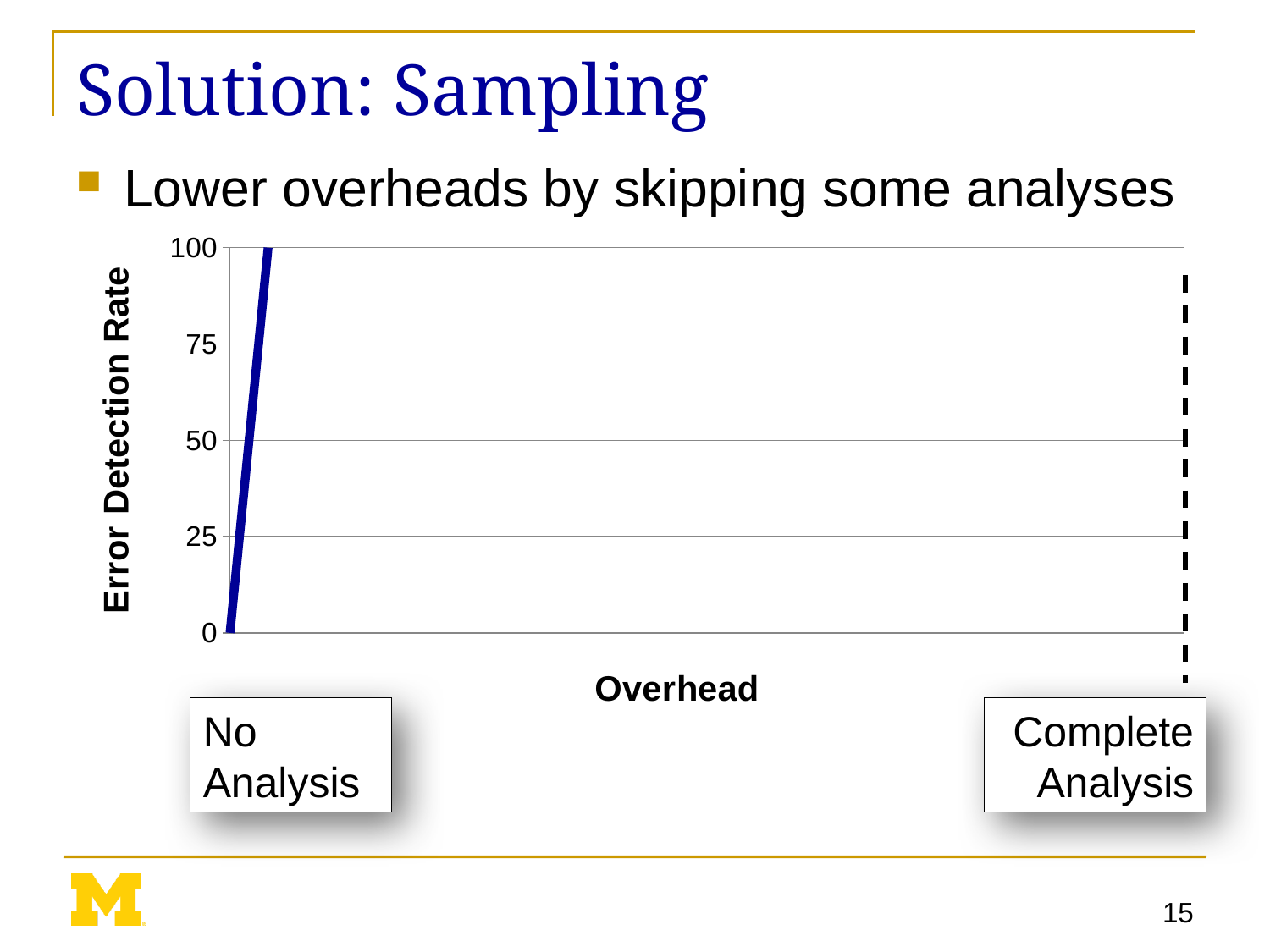
What is the lowest tick value shown on the Error Detection Rate axis? 0 How many tick values are labelled on the Error Detection Rate axis? 5 What is the label of the vertical axis of the chart? Error Detection Rate What is the label of the horizontal axis of the chart? Overhead What is the highest tick value shown on the Error Detection Rate axis? 100 What is the interval between consecutive tick labels on the Error Detection Rate axis? 25 Does the plotted line rise or fall as Overhead increases along the x axis? Rises What kind of chart is shown on the slide? Line chart